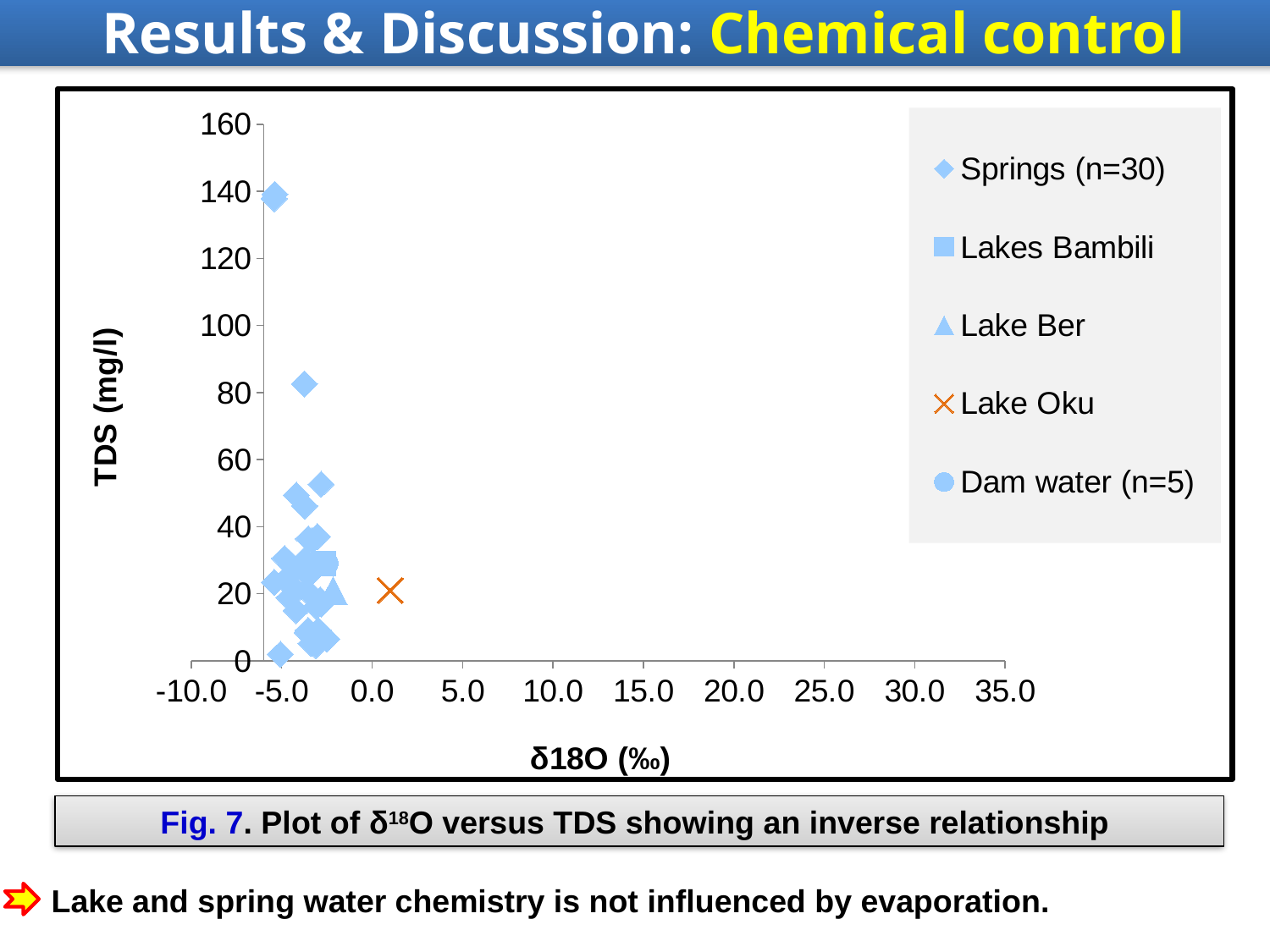
Is the highest TDS value plotted for Springs greater or less than 120? greater Which series has the point with the highest TDS value? Springs (n=30) What is the maximum value shown on the y axis? 160 What is the label of the y axis? TDS (mg/l) What kind of chart is shown on the slide? scatter chart Is the TDS value for the Lake Oku point greater or less than 40? less According to the legend, how many dam water samples (n) are plotted? 5 Which series has the point with the highest δ18O value? Lake Oku What is the label of the x axis? δ18O (‰) According to the legend, how many spring samples (n) are plotted? 30 Is the δ18O value for the Lake Oku point greater or less than 0.0? greater How many series does the legend list? 5